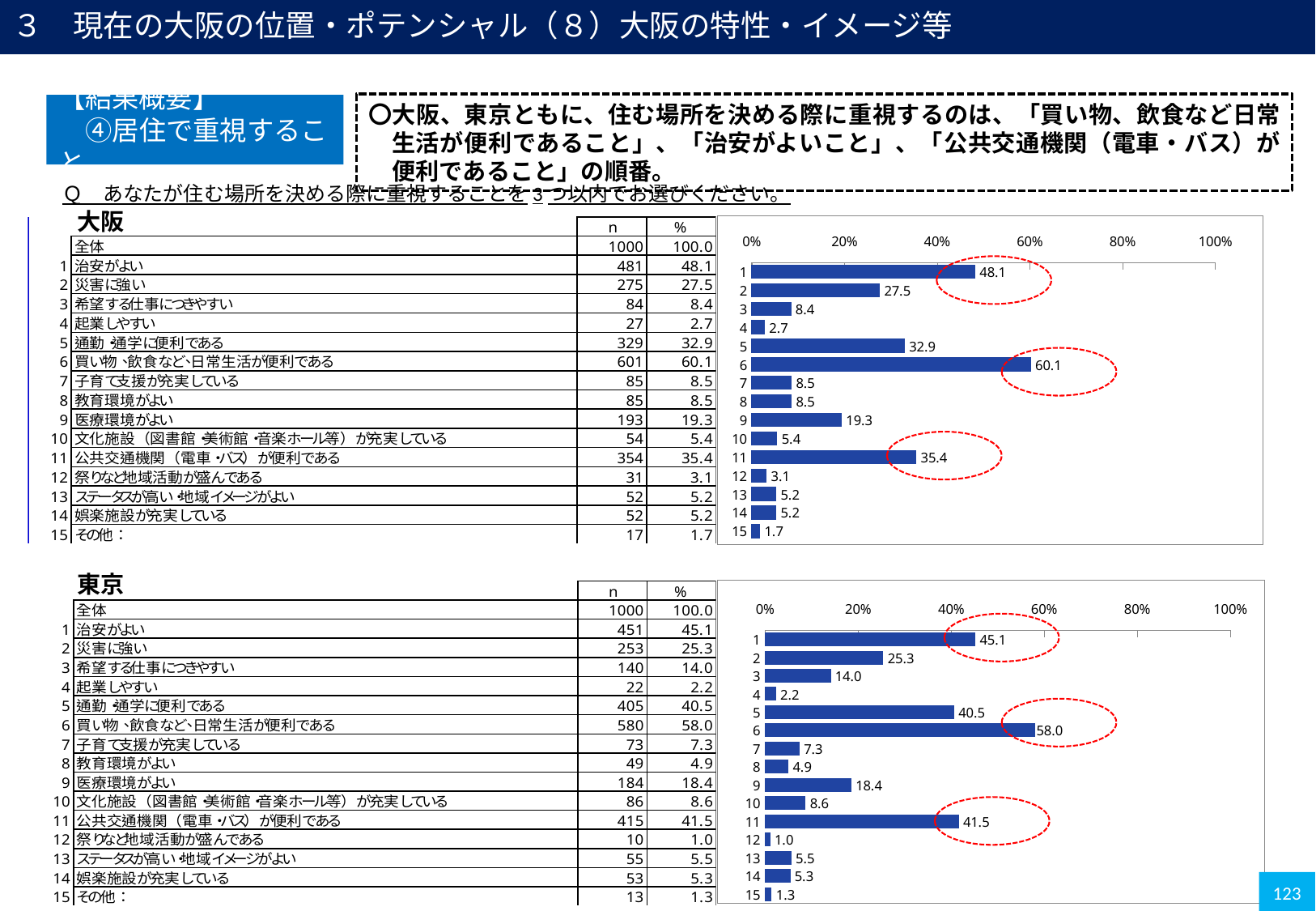
In the 東京 chart, what is the value shown for category 11 (公共交通機関（電車・バス）が便利である)? 41.5 In the 大阪 chart, which category has the highest value? 6 (買い物、飲食など、日常生活が便利である) In the 東京 chart, which is larger: the value for category 5 (通勤・通学に便利である) or category 11 (公共交通機関（電車・バス）が便利である)? Category 11 (41.5) In the 東京 chart, which category has the lowest value? 12 (祭りなど地域活動が盛んである) In the 大阪 chart, what is the value shown for category 6 (買い物、飲食など、日常生活が便利である)? 60.1 In the 大阪 chart, which category has the lowest value? 15 (その他) How many categories are plotted in the 大阪 chart? 15 In the 東京 chart, what is the difference between the values for category 6 (買い物、飲食など、日常生活が便利である) and category 1 (治安がよい)? 12.9 What kind of chart is used for the 東京 data? Bar chart In the 東京 chart, which category has the highest value? 6 (買い物、飲食など、日常生活が便利である) In the 大阪 chart, is the value for category 5 (通勤・通学に便利である) greater or less than 40%? less In the 大阪 chart, what is the difference between the values for category 1 (治安がよい) and category 2 (災害に強い)? 20.6